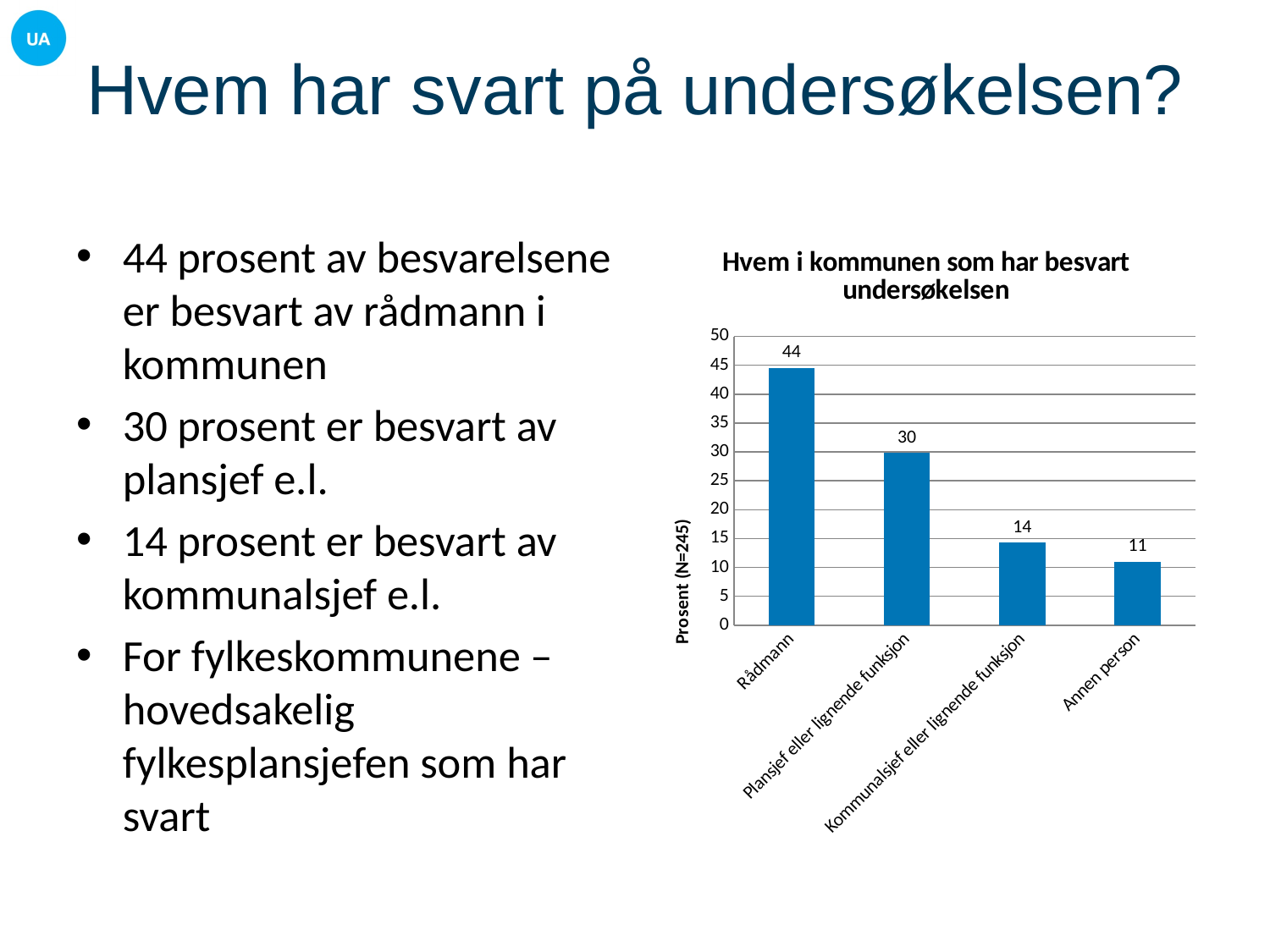
What is the value for Kommunalsjef eller lignende funksjon? 14 What is the difference between the values for Rådmann and Plansjef eller lignende funksjon? 14 Which category has the highest value? Rådmann Is the value for Plansjef eller lignende funksjon greater or less than 25? greater Which category has the lowest value? Annen person How many categories are shown on the x axis? 4 What is the value for Annen person? 11 What is the value for Rådmann? 44 What kind of chart is shown on the slide? bar chart What is the title of the chart? Hvem i kommunen som har besvart undersøkelsen Which is larger, the value for Kommunalsjef eller lignende funksjon or Annen person? Kommunalsjef eller lignende funksjon What is the value for Plansjef eller lignende funksjon? 30